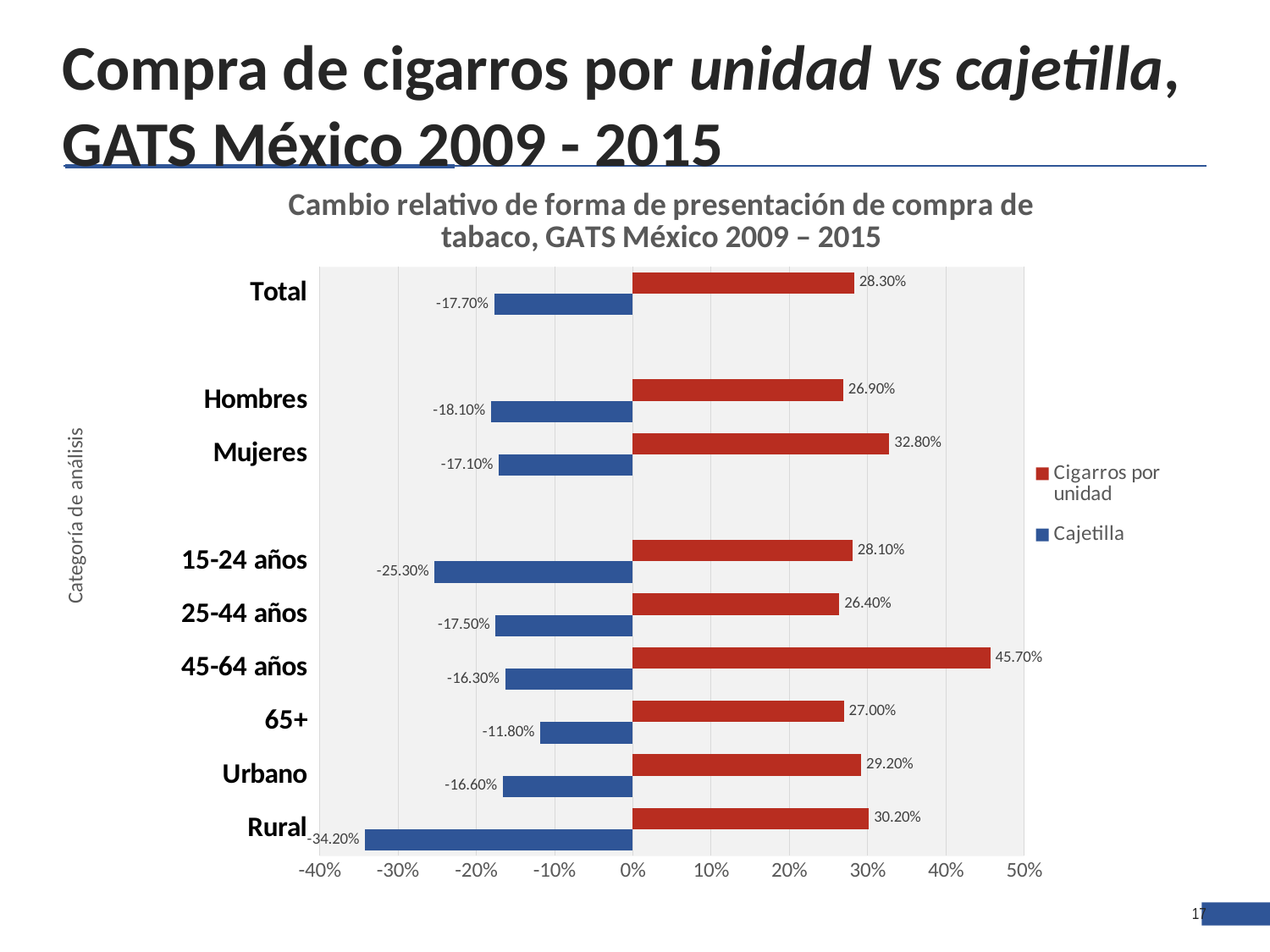
What is the value for Cajetilla for 15-24 años? -25.30% Which series is shown in blue in the legend? Cajetilla Which category has the highest value for Cigarros por unidad? 45-64 años What is the value for Cajetilla for Rural? -34.20% What kind of chart is shown on the slide? Bar chart What is the difference between the Cigarros por unidad values for Mujeres and Hombres? 5.90% Which category has the lowest value for Cajetilla? Rural What is the value for Cajetilla for 65+? -11.80% Which is larger, the Cigarros por unidad value for Rural or for Urbano? Rural How many series does the legend list? 2 What is the value for Cigarros por unidad for the Total category? 28.30% How many categories are shown on the y axis? 9